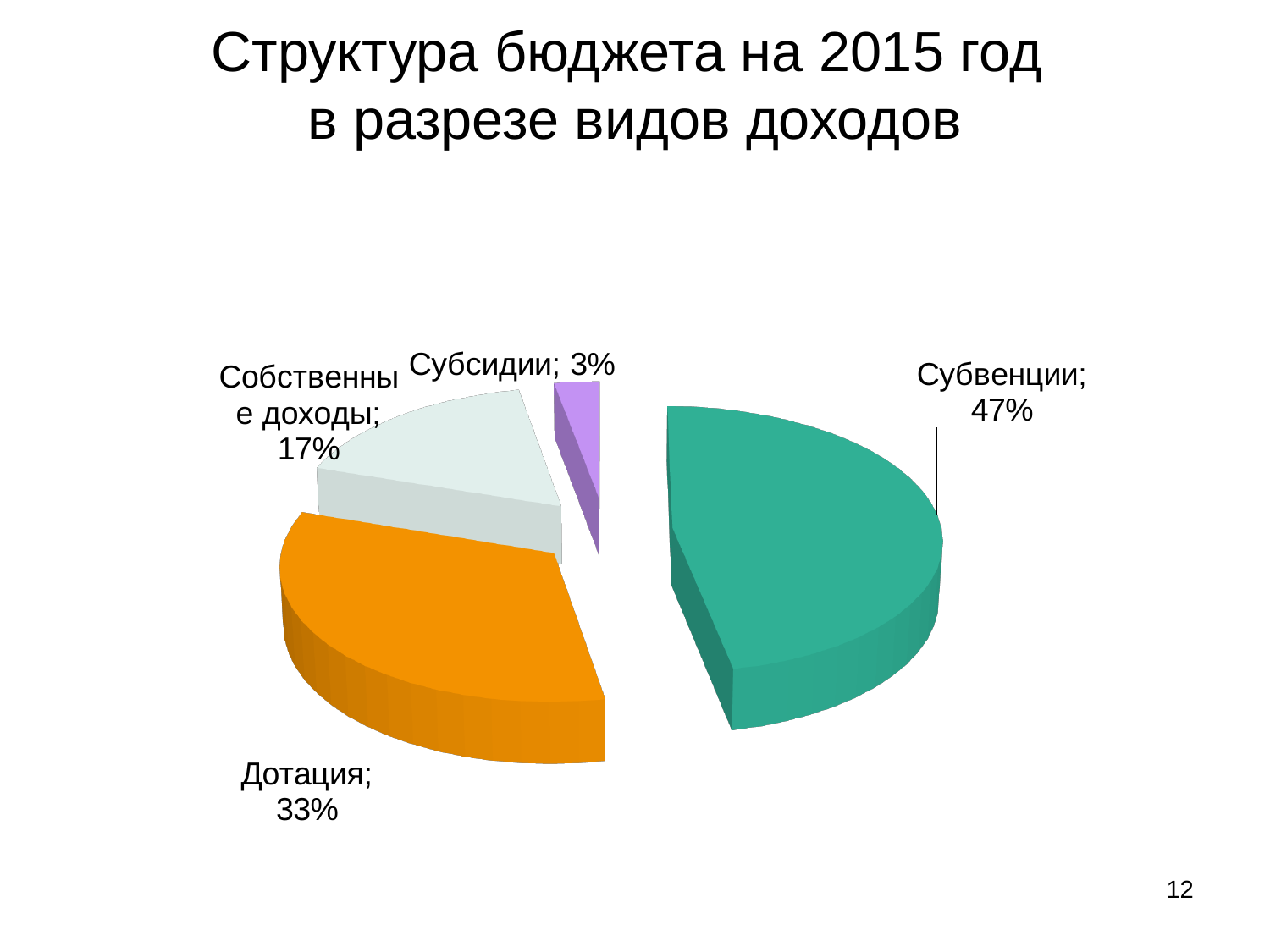
What kind of chart is shown on the slide? Pie chart What is the difference in percentage points between Собственные доходы and Субсидии? 14 Which is larger, the share for Дотация or the share for Собственные доходы? Дотация How many categories are shown in the pie chart? 4 What share of the pie does Дотация represent? 33% What share of the pie does Субвенции represent? 47% Which category has the smallest share of the pie? Субсидии What is the difference in percentage points between Субвенции and Дотация? 14 Which category has the largest share of the pie? Субвенции What is the title of the slide containing the chart? Структура бюджета на 2015 год в разрезе видов доходов What share of the pie does Собственные доходы represent? 17% What share of the pie does Субсидии represent? 3%